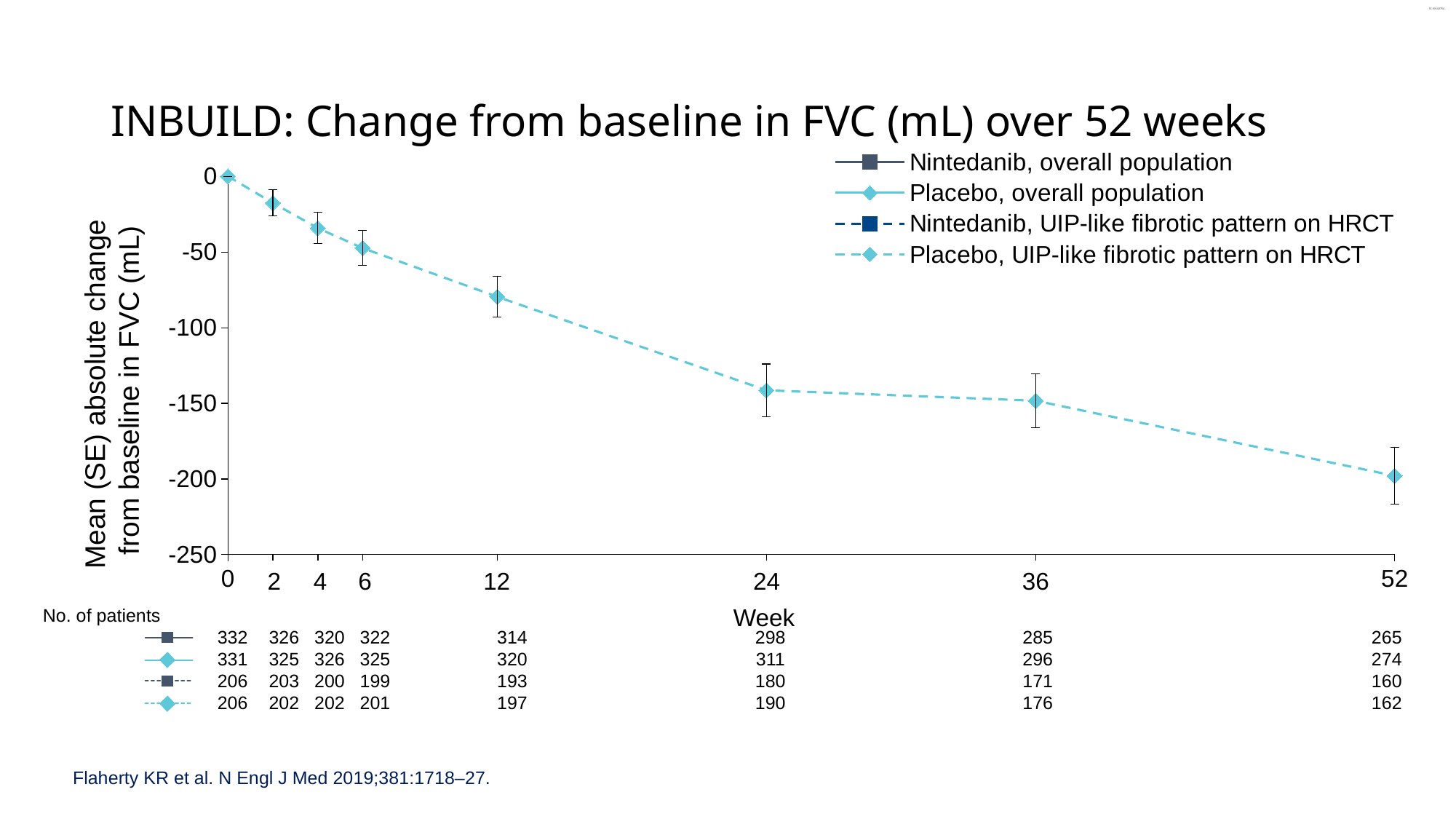
Is the plotted value at week 12 greater or less than -100? greater Which is larger, the plotted value at week 12 or at week 24? week 12 Is the plotted value at week 24 greater or less than -100? less How many time points (weeks) are marked on the x axis? 8 Is the plotted value at week 52 greater or less than -150? less At which week is the plotted mean change from baseline in FVC lowest? 52 What is the plotted mean change from baseline in FVC at week 0? 0 According to the 'No. of patients' table, how many patients were in the Placebo, overall population group at week 52? 274 Do the plotted values rise or fall as the weeks increase? fall What is the label of the x axis? Week How many series does the legend list? 4 What kind of chart is shown on the slide? line chart